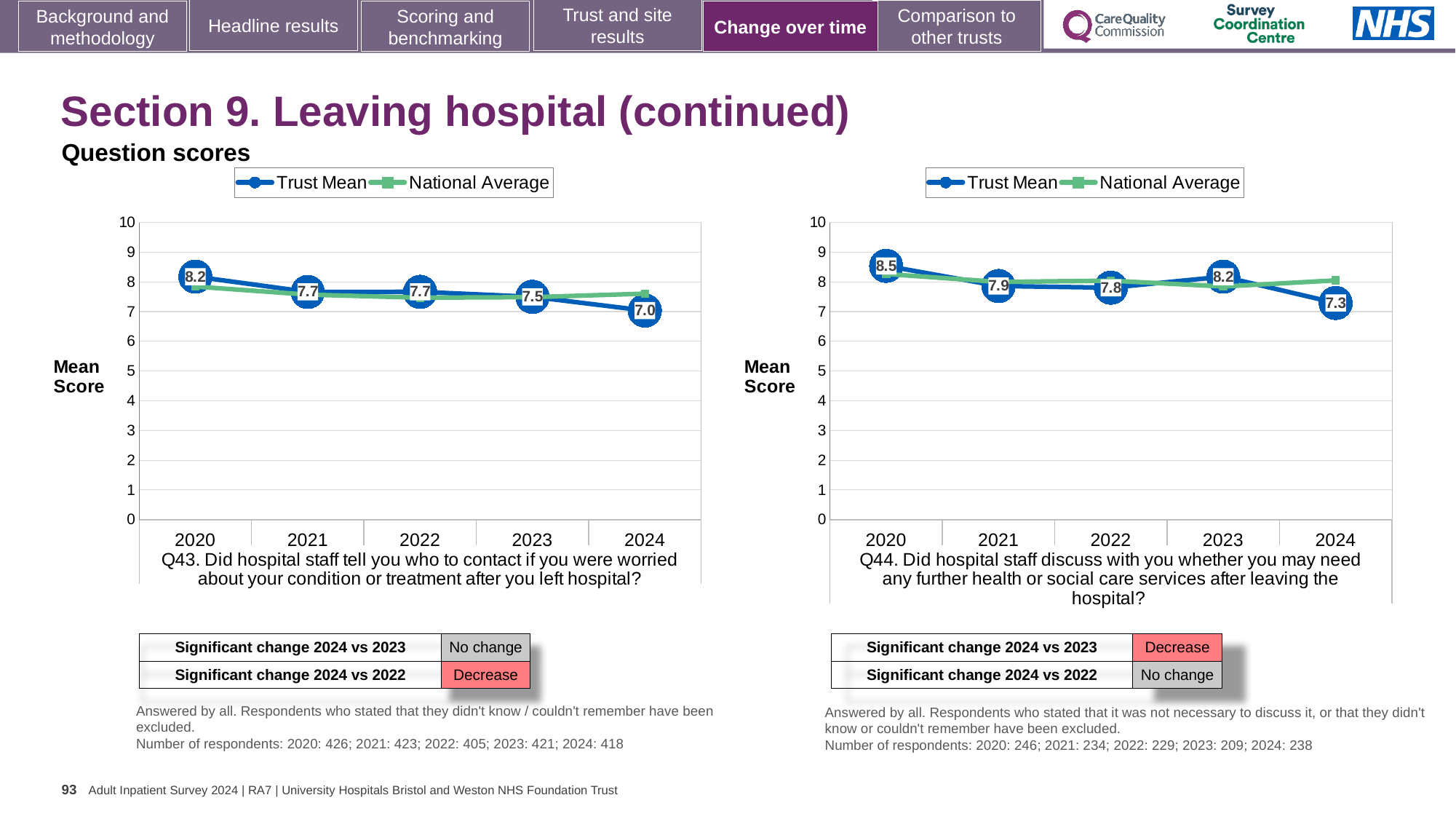
On the Q44 chart (right), which year has the highest Trust Mean score? 2020 On the Q43 chart (left), is the Trust Mean score for 2021 or 2023 larger? 2021 On the Q44 chart (right), what is the Trust Mean score for 2023? 8.2 How many years are plotted on the Q43 chart (left)? 5 On the Q44 chart (right), what is the difference between the Trust Mean scores for 2020 and 2024? 1.2 On the Q43 chart (left), what is the Trust Mean score for 2020? 8.2 How many series does the legend of the Q44 chart (right) list? 2 On the Q44 chart (right), is the National Average for 2024 greater or less than 7? greater On the Q43 chart (left), does the Trust Mean score rise or fall from 2020 to 2024? Fall What type of chart is used for Q43 (left)? Line chart On the Q43 chart (left), what is the Trust Mean score for 2024? 7.0 On the Q43 chart (left), which year has the lowest Trust Mean score? 2024